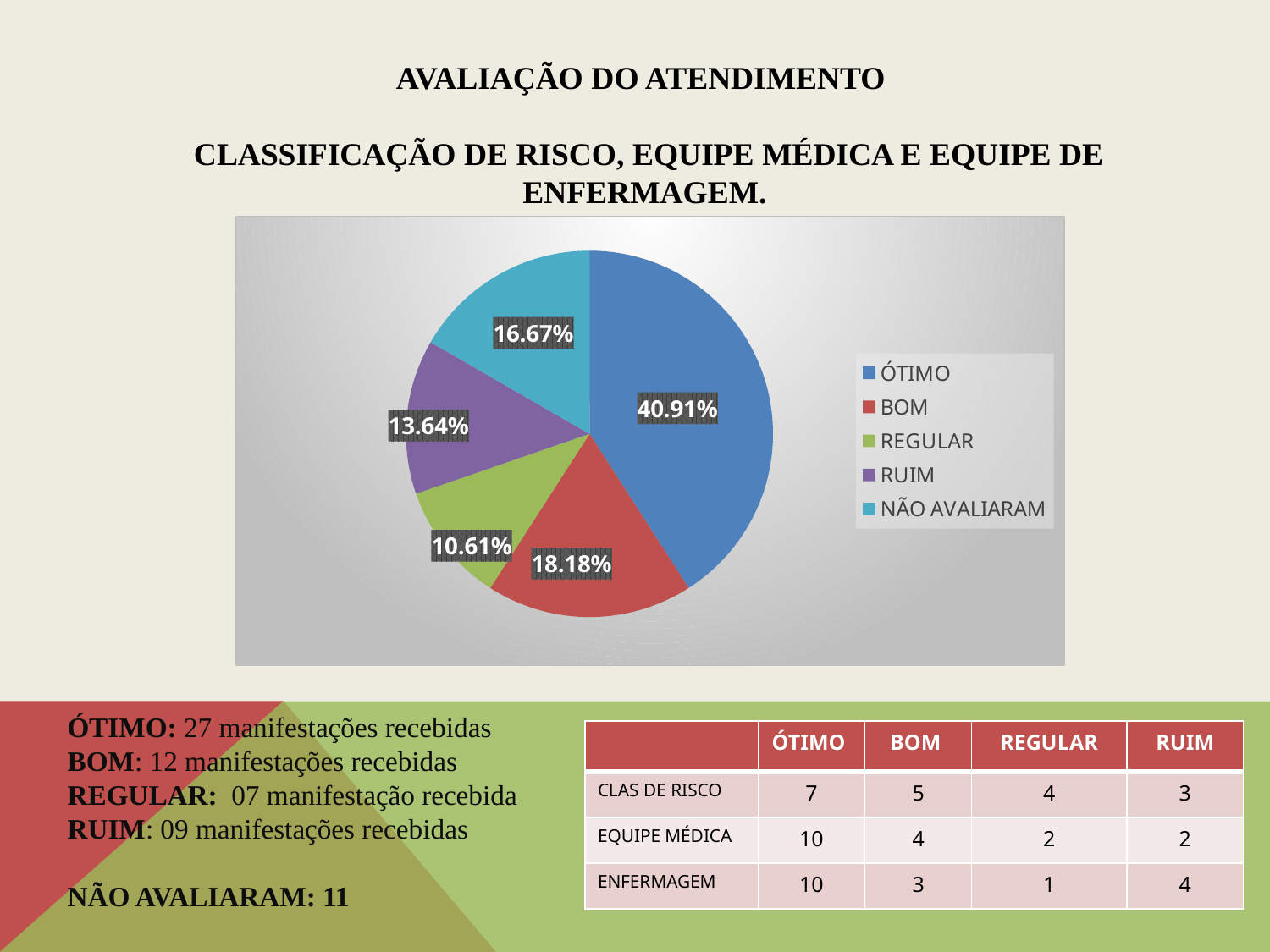
How many slices does the pie chart have? 5 Which slice is larger in the pie chart, RUIM or REGULAR? RUIM What is the difference in percentage points between the ÓTIMO slice and the BOM slice? 22.73% How many entries does the legend of the pie chart list? 5 What percentage of the pie chart is labelled BOM? 18.18% What percentage of the pie chart is labelled REGULAR? 10.61% What type of chart is shown on the slide? Pie chart Which category has the smallest slice of the pie chart? REGULAR What percentage of the pie chart is labelled ÓTIMO? 40.91% Which category has the largest slice of the pie chart? ÓTIMO What percentage of the pie chart is labelled RUIM? 13.64% What percentage of the pie chart is labelled NÃO AVALIARAM? 16.67%